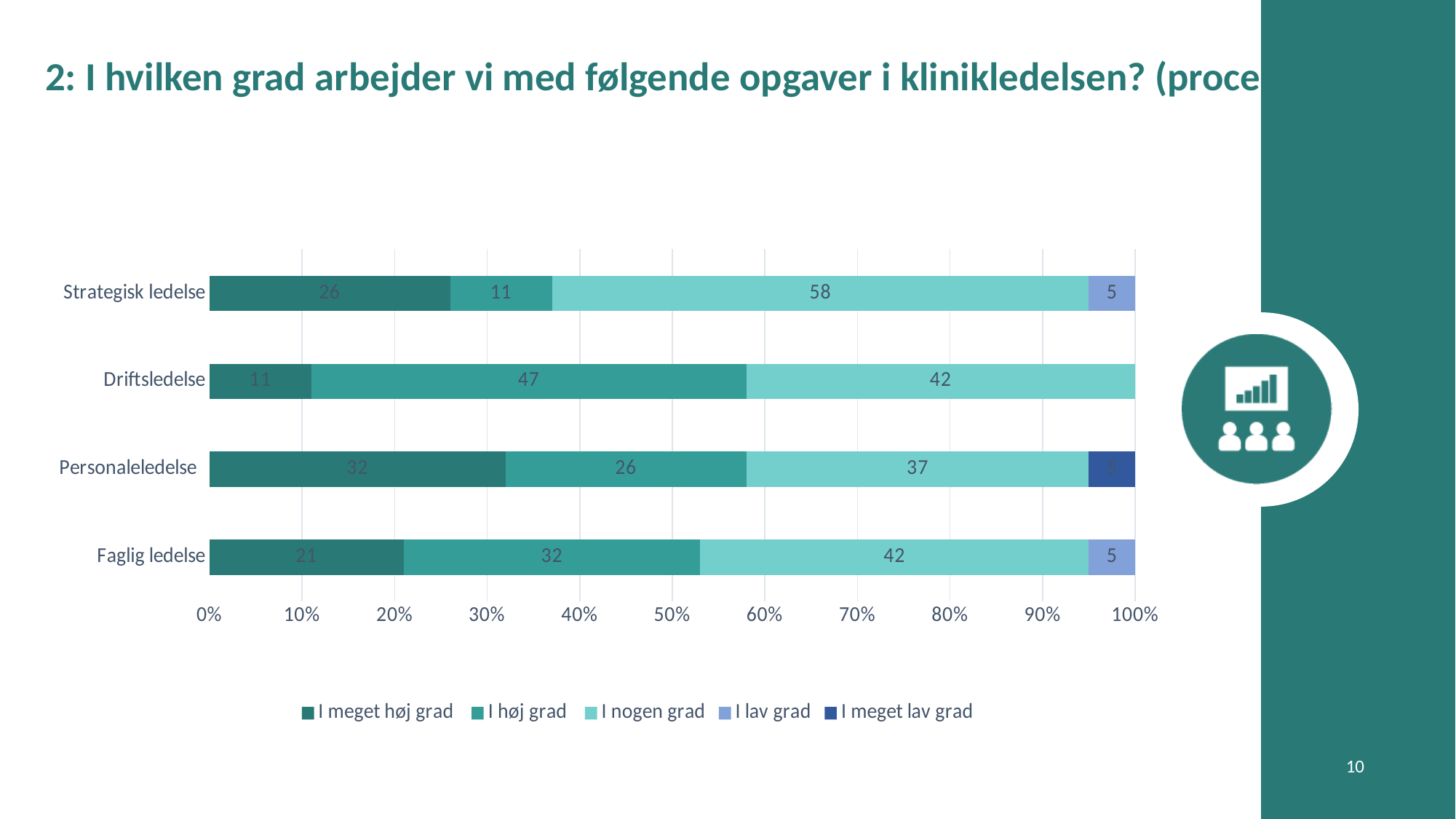
What is the value for "I meget lav grad" for Personaleledelse? 5 Which category has the highest value for "I meget høj grad"? Personaleledelse Which is larger: the "I høj grad" value for Faglig ledelse or for Personaleledelse? Faglig ledelse What is the value for "I høj grad" for Driftsledelse? 47 What is the difference between the "I nogen grad" values for Strategisk ledelse and Personaleledelse? 21 Which category has the lowest value for "I høj grad"? Strategisk ledelse How many series does the legend list? 5 What is the value for "I meget høj grad" for Personaleledelse? 32 What is the total of the "I meget høj grad" and "I høj grad" values for Driftsledelse? 58 What is the value for "I nogen grad" for Strategisk ledelse? 58 How many categories are shown on the y axis? 4 What kind of chart is shown on the slide? Stacked bar chart